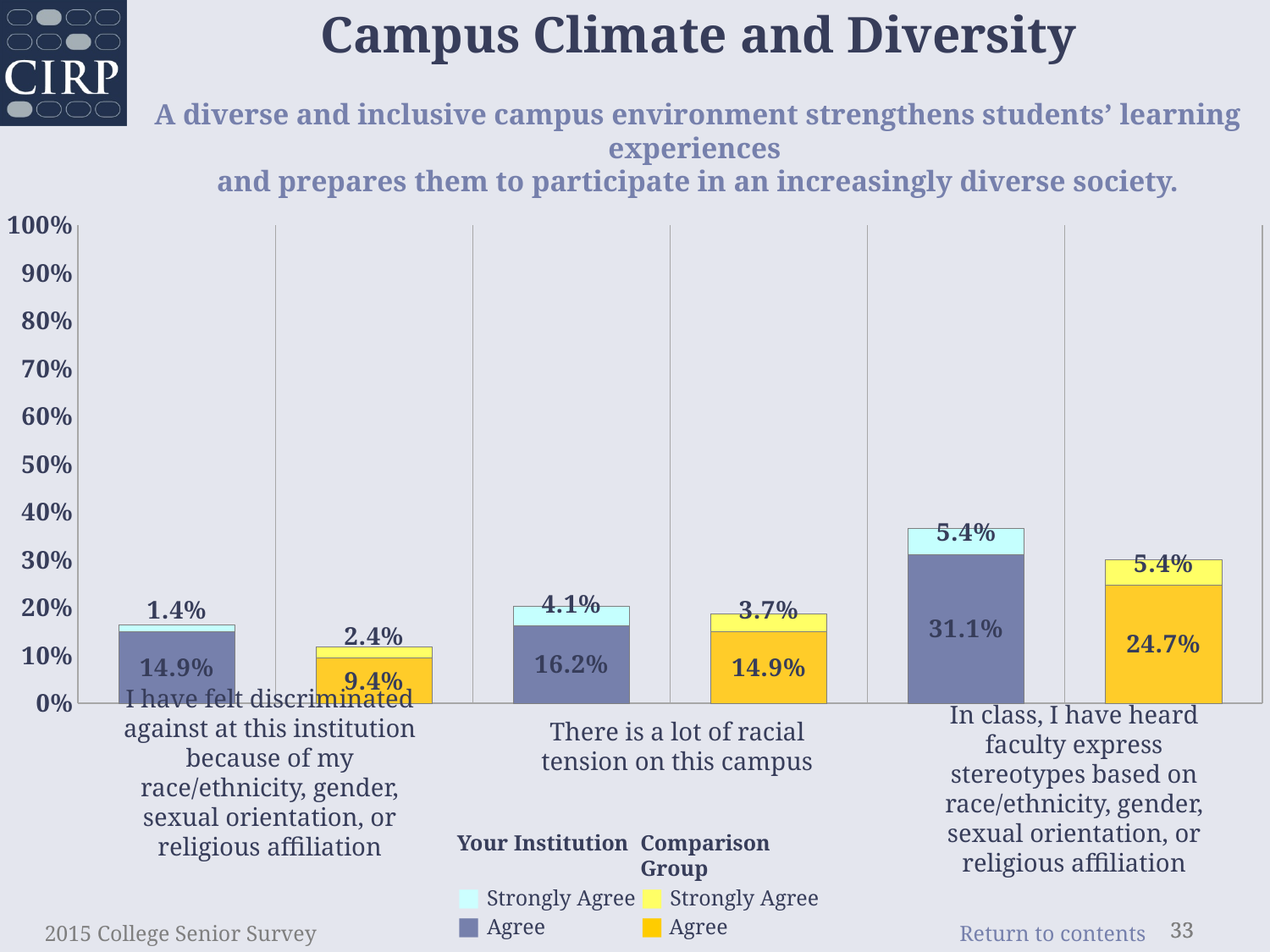
Which statement has the lowest Comparison Group Agree value? I have felt discriminated against at this institution because of my race/ethnicity, gender, sexual orientation, or religious affiliation What is the total percentage (Agree plus Strongly Agree) for the Comparison Group on the statement about feeling discriminated against at this institution? 11.8% What percentage of Your Institution students agree that they have felt discriminated against at this institution? 14.9% What percentage of Your Institution students agree that in class they have heard faculty express stereotypes? 31.1% What percentage of the Comparison Group strongly agree that there is a lot of racial tension on this campus? 3.7% Which statement has the highest Your Institution Agree value? In class, I have heard faculty express stereotypes based on race/ethnicity, gender, sexual orientation, or religious affiliation What kind of chart is shown on the slide? Stacked bar chart What is the difference between the Your Institution Agree value and the Comparison Group Agree value for the statement about faculty expressing stereotypes in class? 6.4% How many entries does the chart legend list? 4 How many statements (categories) are shown on the x axis of the chart? 3 Which is larger for the statement about racial tension on campus: the Your Institution Agree value or the Comparison Group Agree value? Your Institution What is the total percentage (Agree plus Strongly Agree) for Your Institution on the statement about hearing faculty express stereotypes in class? 36.5%